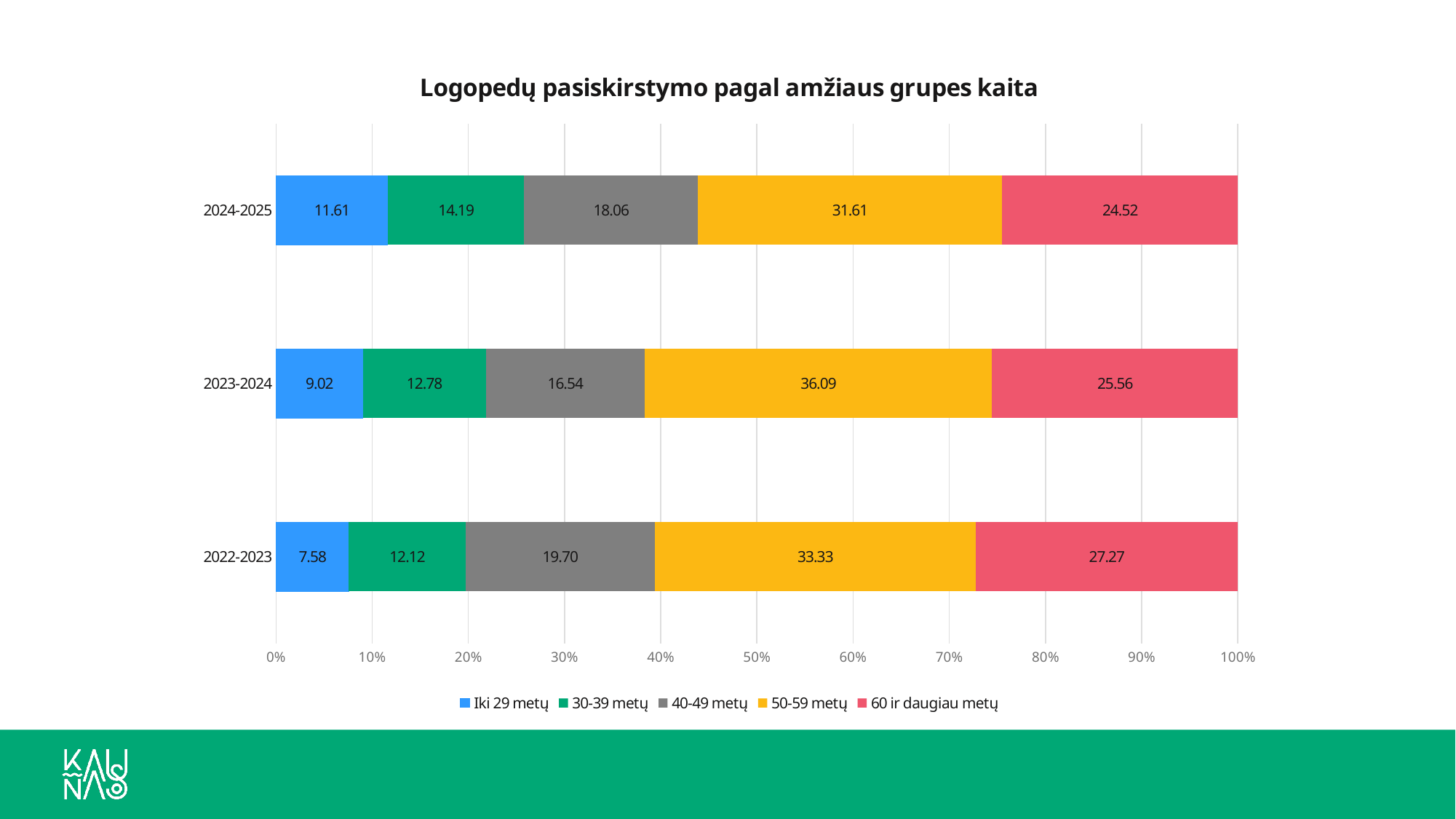
In which year is the value for 60 ir daugiau metų the lowest? 2024-2025 What is the value for 60 ir daugiau metų in 2024-2025? 24.52 What is the difference between the 50-59 metų values for 2023-2024 and 2024-2025? 4.48 How many series does the legend list? 5 How many years (categories) are shown on the chart? 3 What is the value for Iki 29 metų in 2022-2023? 7.58 What is the value for 50-59 metų in 2023-2024? 36.09 Which age group has the largest value in the 2024-2025 bar? 50-59 metų What is the title of the chart? Logopedų pasiskirstymo pagal amžiaus grupes kaita Which is larger: the 30-39 metų value for 2024-2025 or for 2022-2023? 2024-2025 What kind of chart is shown on the slide? Stacked bar chart Does the value for Iki 29 metų rise or fall from 2022-2023 to 2024-2025? Rise